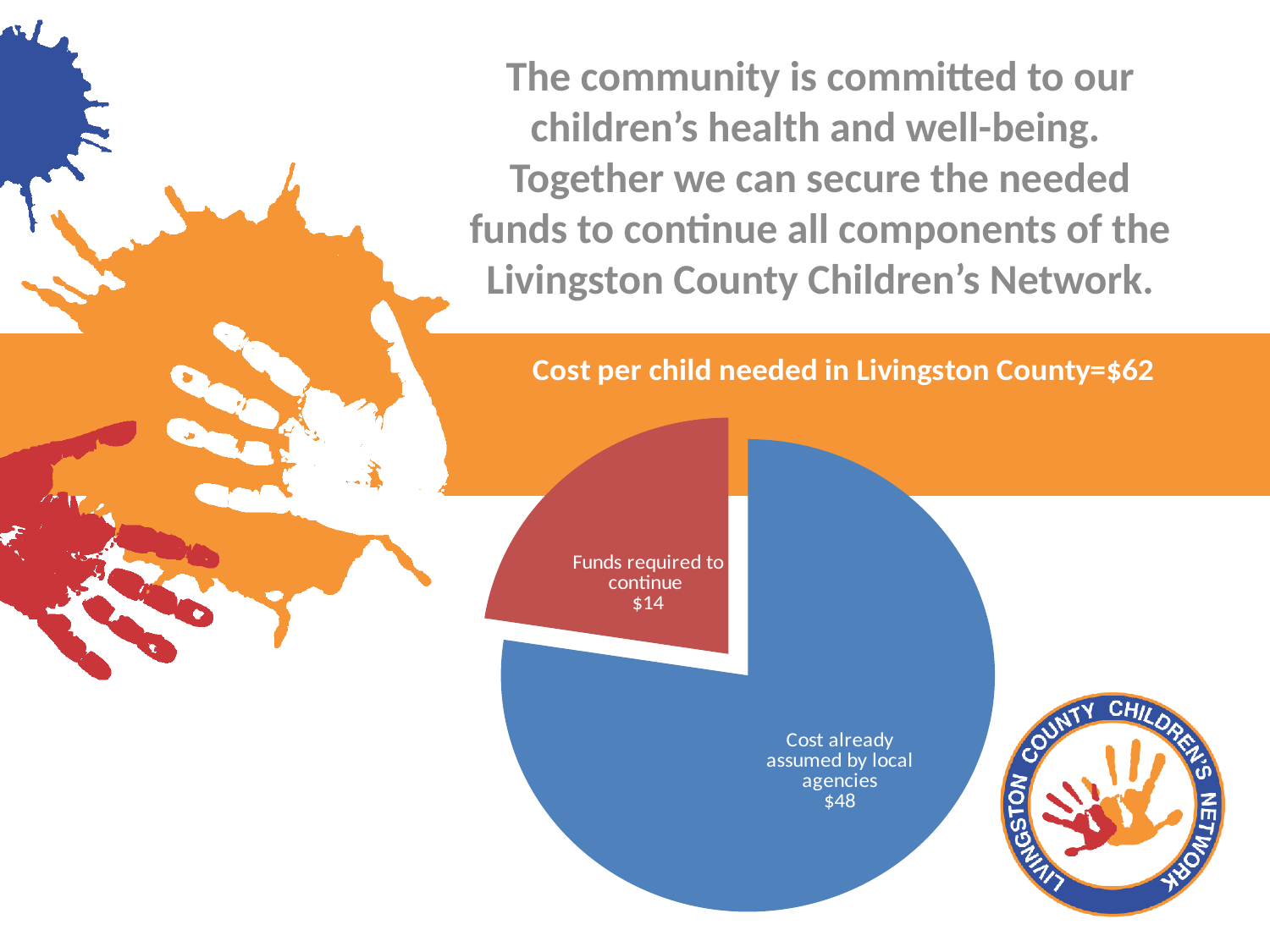
Which slice of the pie chart is the smallest? Funds required to continue Which is larger: the funds required to continue or the cost already assumed by local agencies? Cost already assumed by local agencies What colour is the "Funds required to continue" slice? red What is the value for "Funds required to continue"? $14 Which slice of the pie chart is the largest? Cost already assumed by local agencies How many slices does the pie chart have? 2 What is the value for "Cost already assumed by local agencies"? $48 What is the difference between the cost already assumed by local agencies and the funds required to continue? $34 What is the total of the two slices in the pie chart? $62 What is the title of the chart? Cost per child needed in Livingston County=$62 What type of chart is shown on the slide? pie chart